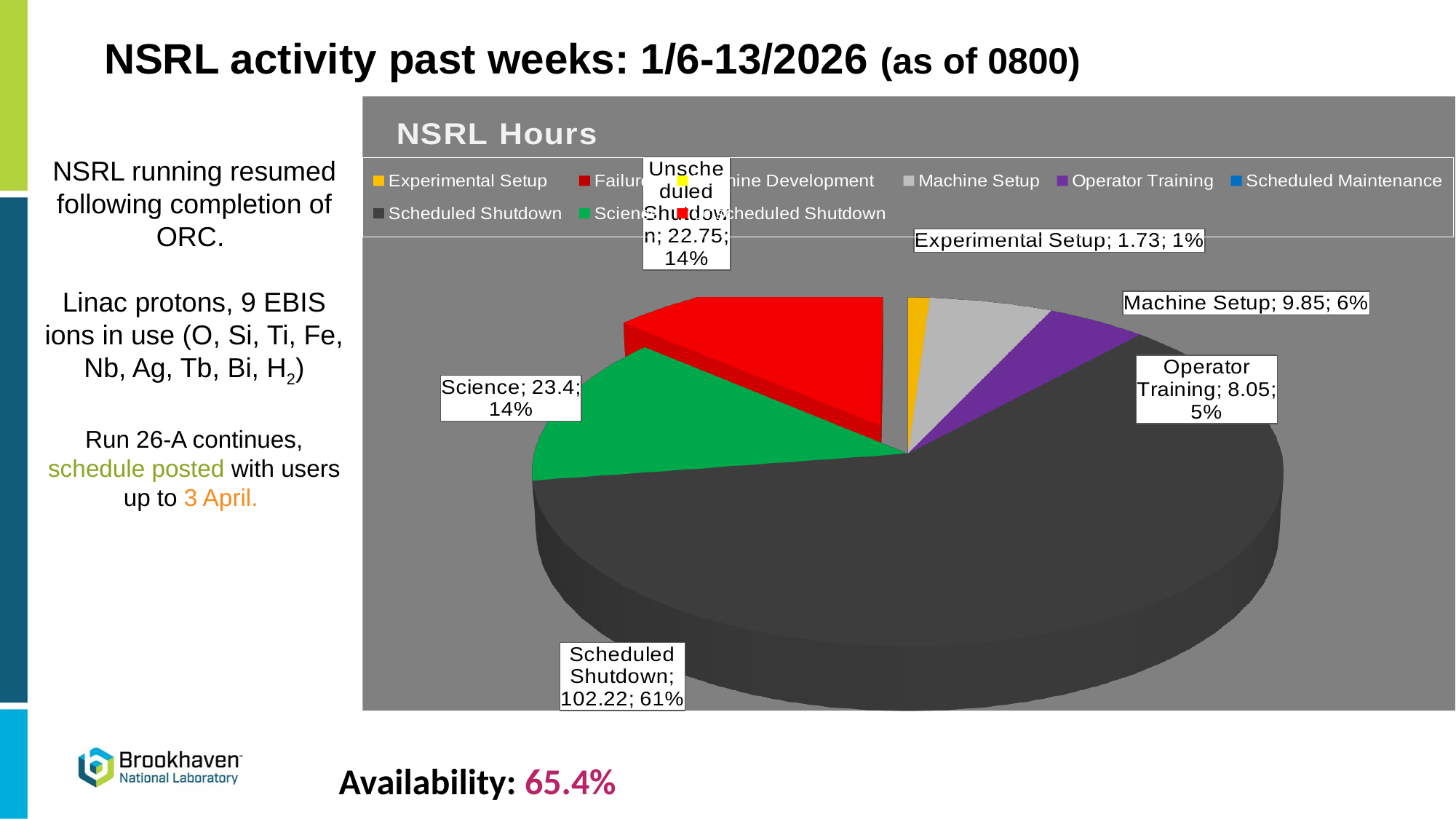
Which labeled category has the smallest slice in the NSRL Hours pie chart? Experimental Setup In the NSRL Hours chart, what is the difference between the Machine Setup and Operator Training values? 1.8 In the NSRL Hours chart, which is larger: Science or Unscheduled Shutdown? Science How many hours are shown for Scheduled Shutdown in the NSRL Hours pie chart? 102.22 What share of the NSRL Hours pie is Operator Training? 5% What is the value for Science in the NSRL Hours chart? 23.4 What type of chart is used to show NSRL Hours? Pie chart Which category has the largest slice in the NSRL Hours pie chart? Scheduled Shutdown What is the value for Machine Setup in the NSRL Hours chart? 9.85 What percentage of the NSRL Hours pie does Scheduled Shutdown represent? 61% What is the value for Unscheduled Shutdown in the NSRL Hours chart? 22.75 How many labeled slices are shown in the NSRL Hours pie chart? 6